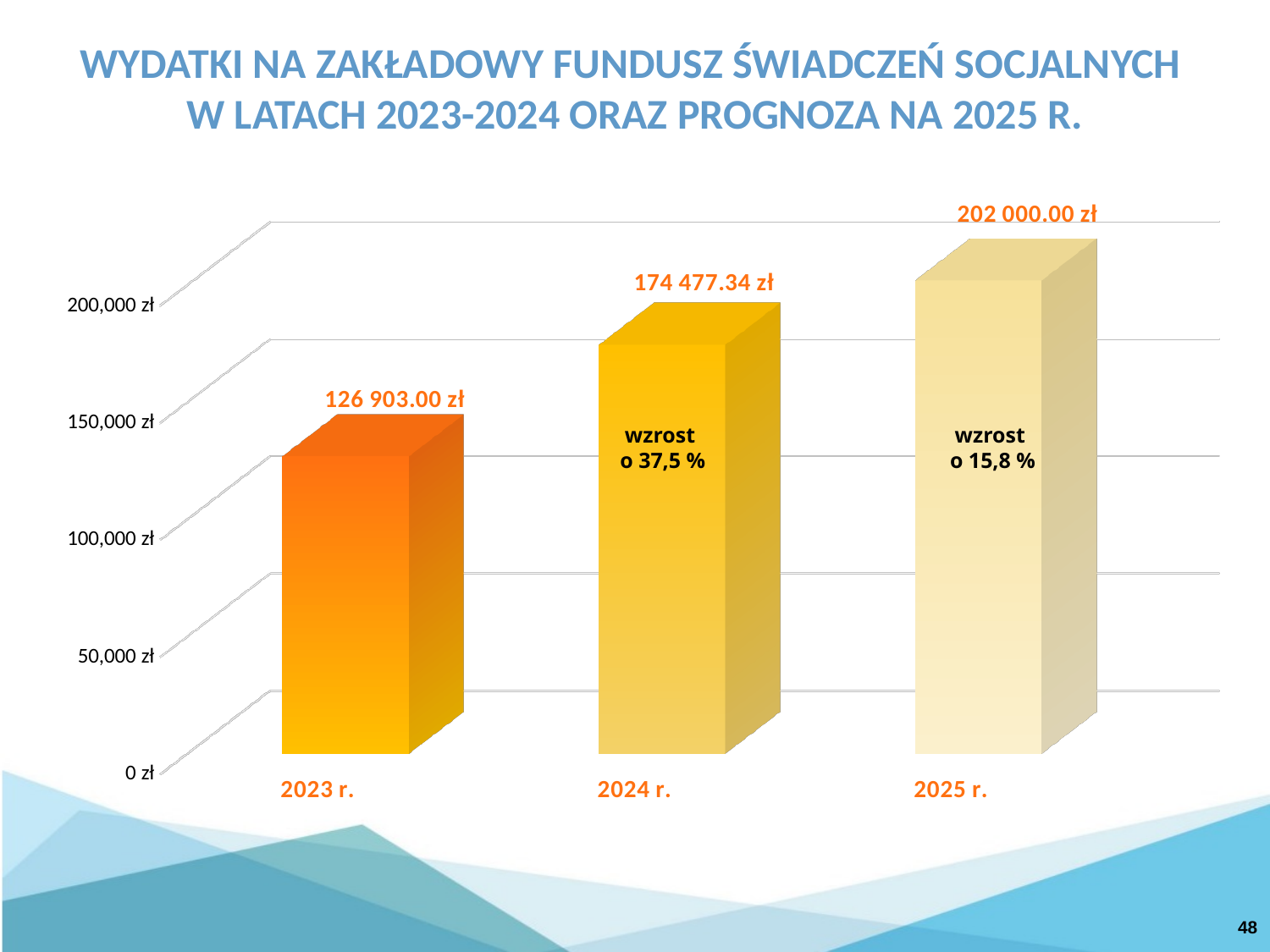
What is the difference between the values for 2024 r. and 2023 r.? 47 574.34 zł What percentage increase is labelled on the bar for 2024 r.? 37,5 % Which year has the lowest value? 2023 r. What is the value shown for 2024 r.? 174 477.34 zł Which is larger, the value for 2024 r. or the value for 2023 r.? 2024 r. Which year has the highest value? 2025 r. What is the value shown for 2025 r.? 202 000.00 zł Is the value for 2023 r. greater or less than 150,000 zł? less What kind of chart is shown on the slide? bar chart What is the value shown for 2023 r.? 126 903.00 zł What is the difference between the values for 2025 r. and 2024 r.? 27 522.66 zł How many years (bars) are shown in the chart? 3